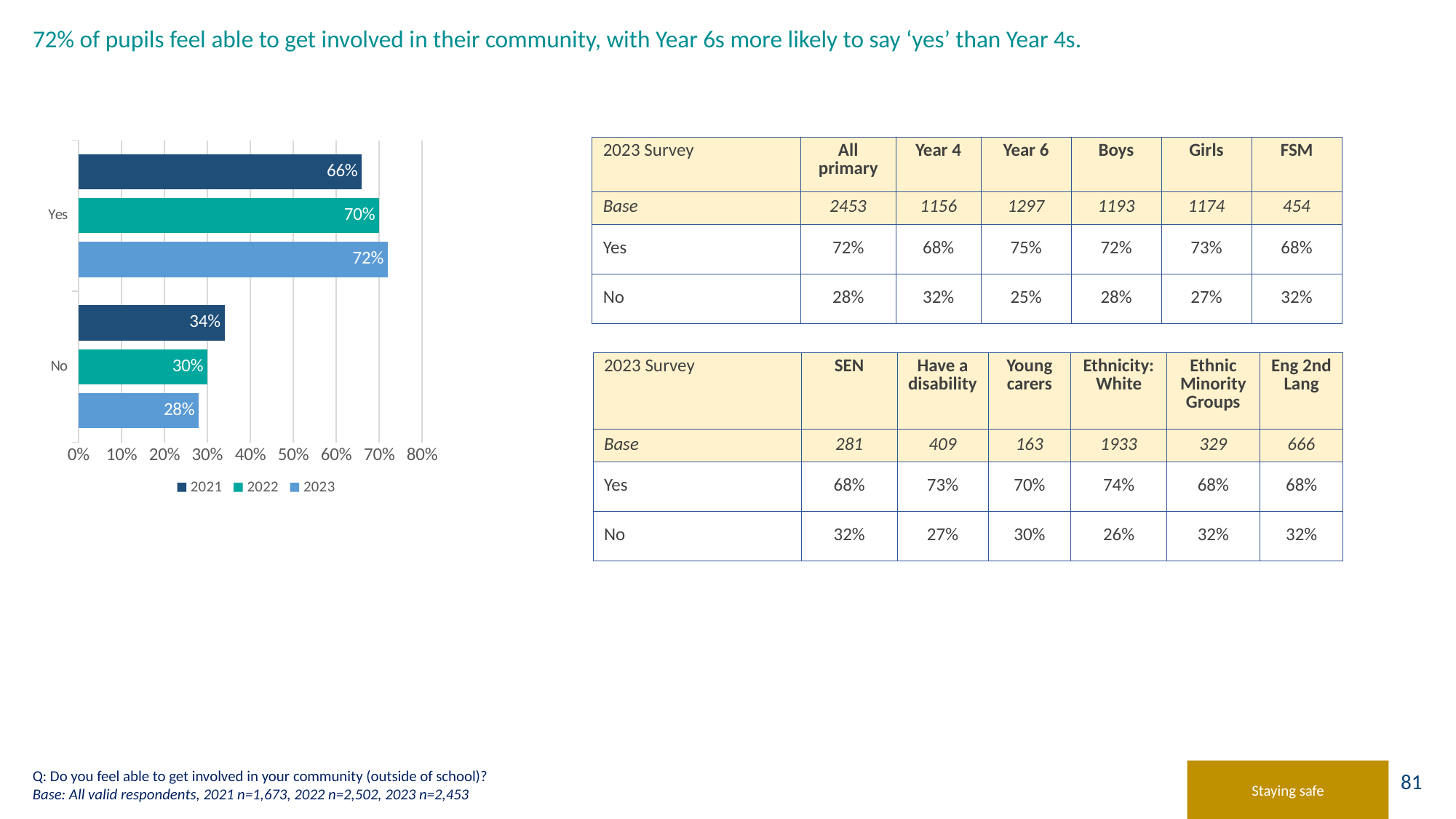
What is the value for 'Yes' in 2023? 72% What is the value for 'No' in 2021? 34% How many categories are shown on the chart's vertical axis? 2 What kind of chart is shown on the slide? Bar chart How many series does the legend list? 3 Which is larger: the 'No' value for 2021 or for 2022? 2021 Is the value for 'Yes' in 2021 greater or less than 60%? greater Which year has the lowest value for 'No'? 2023 Does the 'Yes' value rise or fall from 2021 to 2023? Rise Which year has the highest value for 'Yes'? 2023 What is the difference between the 'Yes' values for 2023 and 2021? 6% What is the value for 'Yes' in 2022? 70%